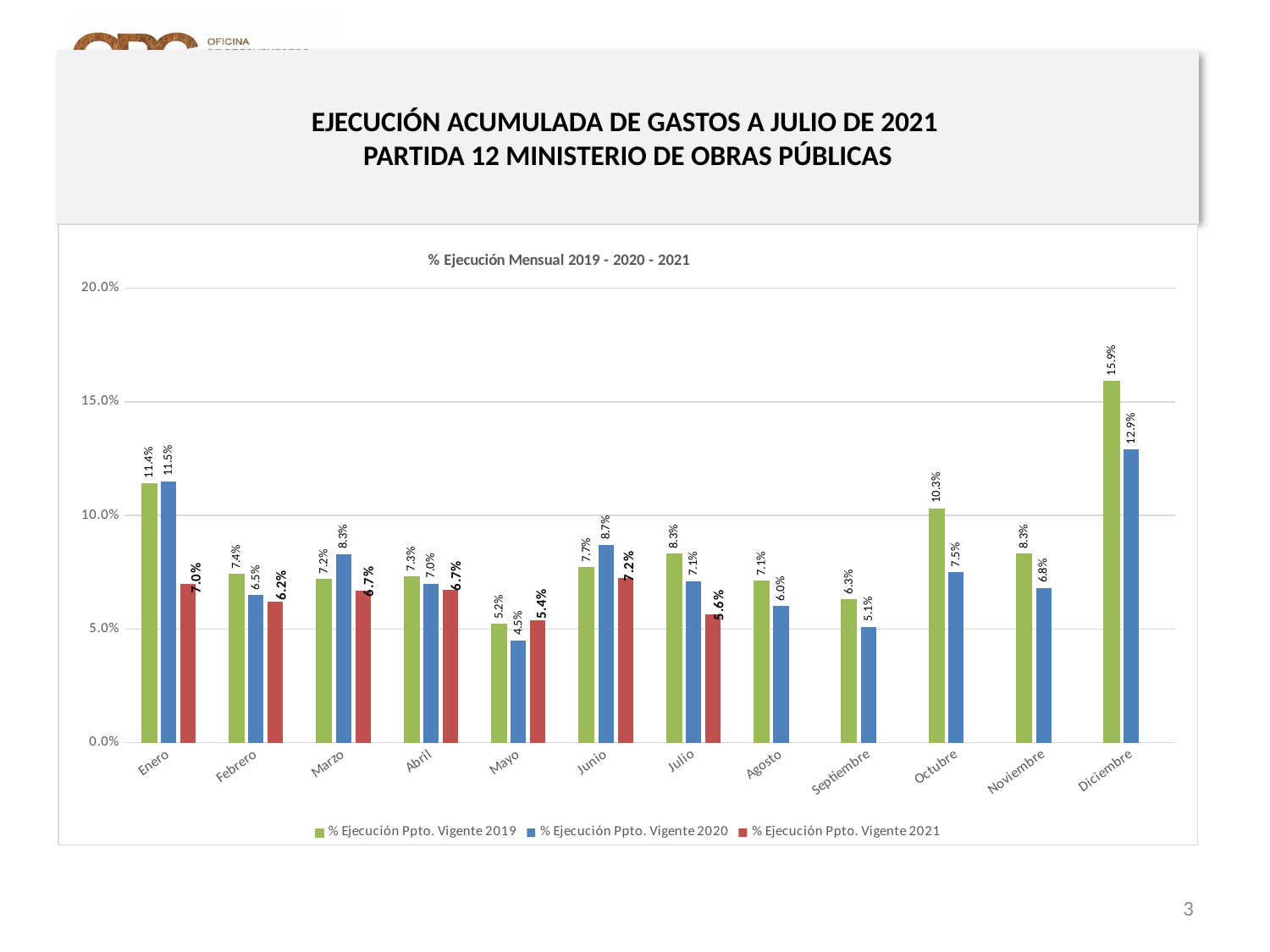
Is the value for Octubre in the 2019 series greater or less than 10.0%? greater What is the difference between the 2019 and 2020 values for Diciembre? 3.0% What is the title of the chart? % Ejecución Mensual 2019 - 2020 - 2021 Which is larger for Junio: the 2019 value or the 2020 value? 2020 value (8.7%) How many series does the legend list? 3 How many months are shown on the x axis? 12 What is the value for Marzo in the % Ejecución Ppto. Vigente 2020 series? 8.3% Which month has the highest value in the % Ejecución Ppto. Vigente 2020 series? Diciembre Which month has the lowest value in the % Ejecución Ppto. Vigente 2019 series? Mayo What kind of chart is shown on the slide? Bar chart What is the value for Mayo in the % Ejecución Ppto. Vigente 2021 series? 5.4% What is the value for Diciembre in the % Ejecución Ppto. Vigente 2019 series? 15.9%